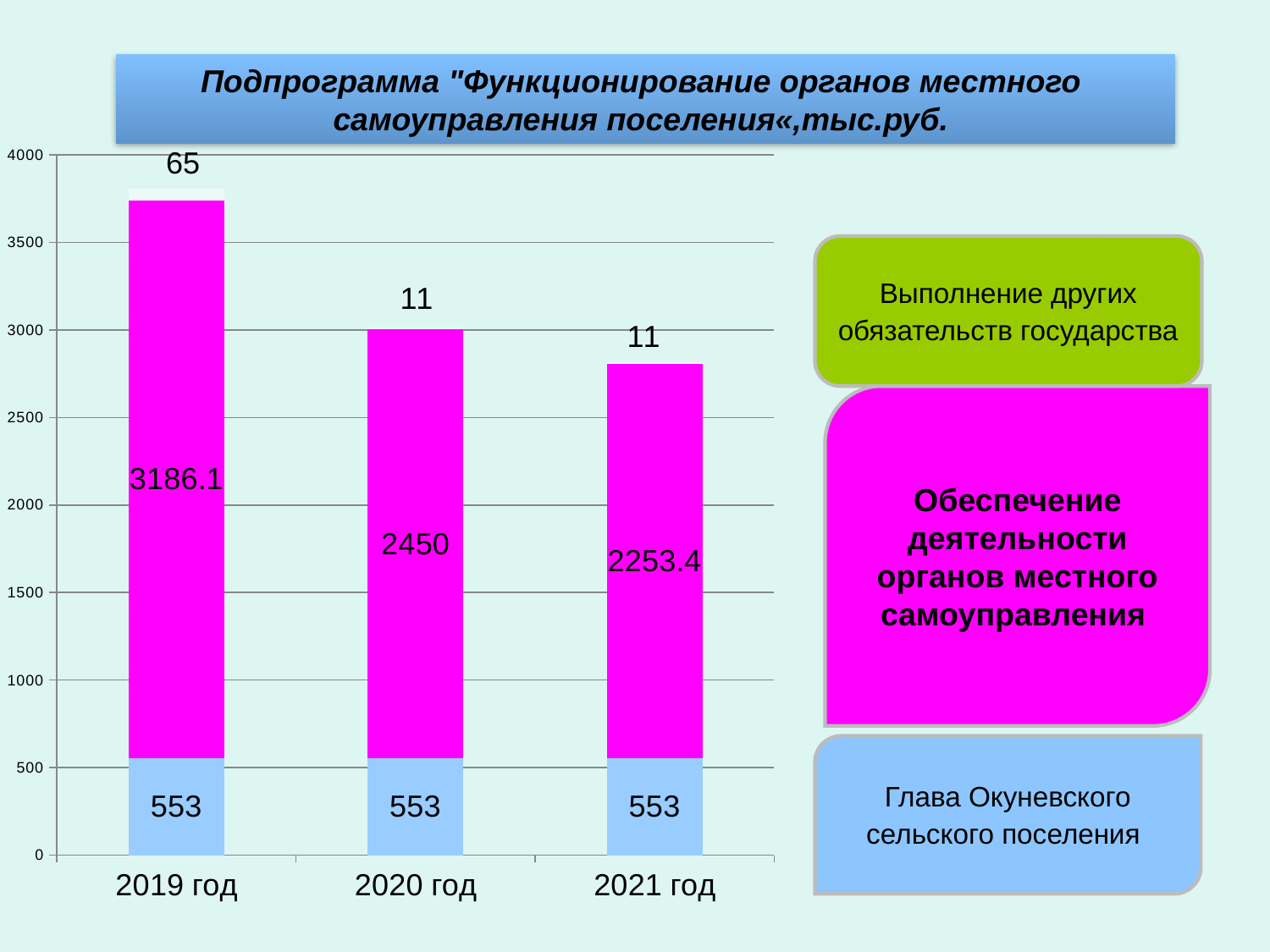
What is the value of the 'Обеспечение деятельности органов местного самоуправления' segment for 2021 год? 2253.4 What is the difference between the 'Обеспечение деятельности органов местного самоуправления' values for 2020 год and 2021 год? 196.6 What is the value of the 'Глава Окуневского сельского поселения' segment for 2020 год? 553 Which is larger: the 'Выполнение других обязательств государства' value for 2019 год or for 2020 год? 2019 год What is the value of the 'Выполнение других обязательств государства' segment for 2019 год? 65 How many series does the chart show? 3 Which year has the lowest value for 'Обеспечение деятельности органов местного самоуправления'? 2021 год Which year has the highest value for 'Обеспечение деятельности органов местного самоуправления'? 2019 год What is the value of the 'Обеспечение деятельности органов местного самоуправления' segment for 2019 год? 3186.1 Does the 'Обеспечение деятельности органов местного самоуправления' value rise or fall from 2019 год to 2021 год? fall How many years are shown on the x axis? 3 What is the total of the stacked bar for 2020 год? 3014